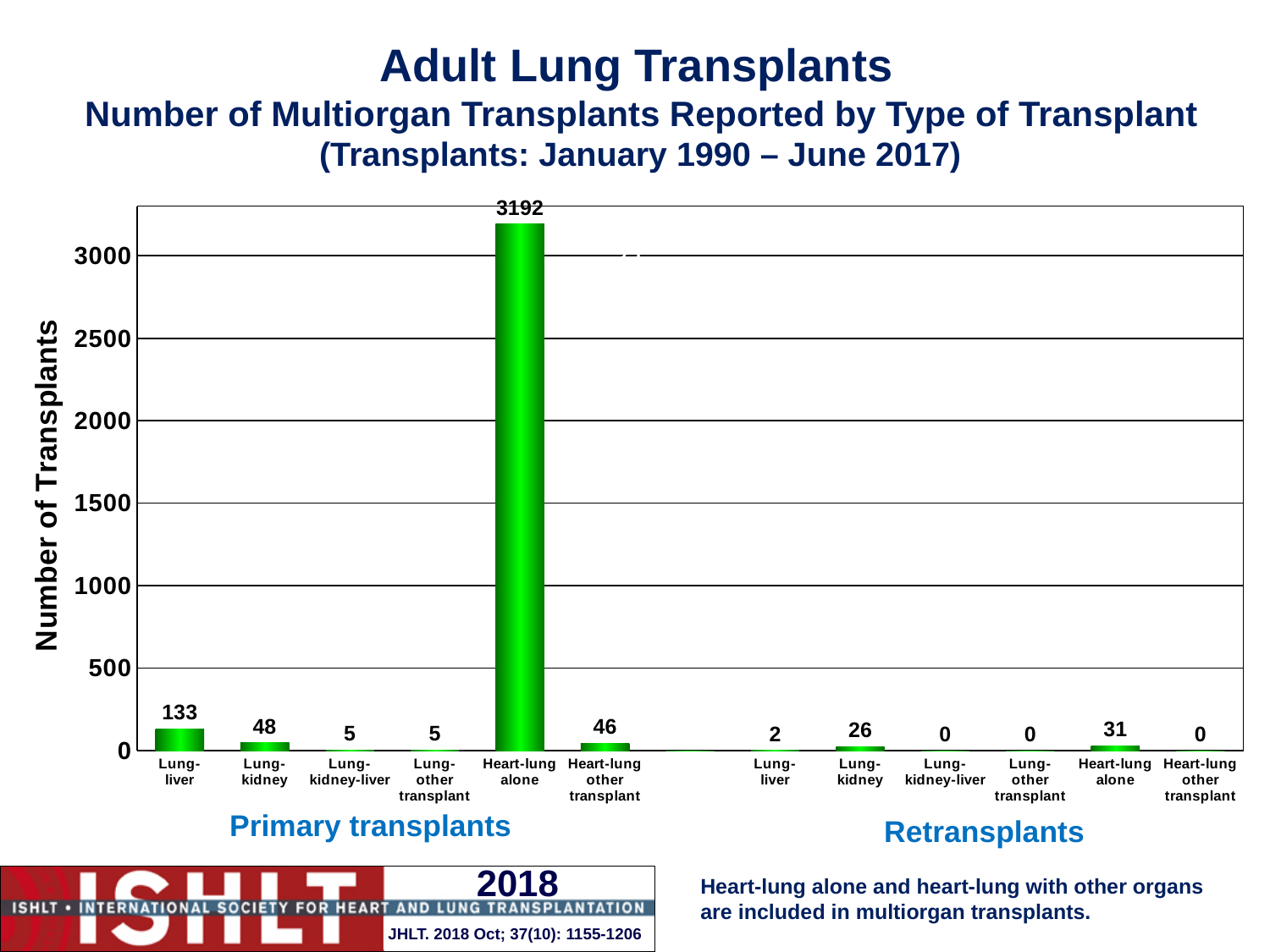
Which is larger: primary Lung-kidney transplants or primary Heart-lung other transplant? Primary Lung-kidney What is the difference between primary Lung-liver and primary Lung-kidney transplants? 85 What kind of chart is shown on the slide? Bar chart Which retransplant type has the highest number of transplants? Heart-lung alone Is the value for primary Heart-lung alone transplants greater or less than 3000? greater Which primary transplant type has the highest number of transplants? Heart-lung alone What is the number of primary Heart-lung alone transplants? 3192 How many transplant type categories are shown in the Retransplants group? 6 What is the number of Lung-kidney retransplants? 26 What is the number of Heart-lung alone retransplants? 31 What is the number of primary Lung-liver transplants? 133 What is the label of the y axis? Number of Transplants